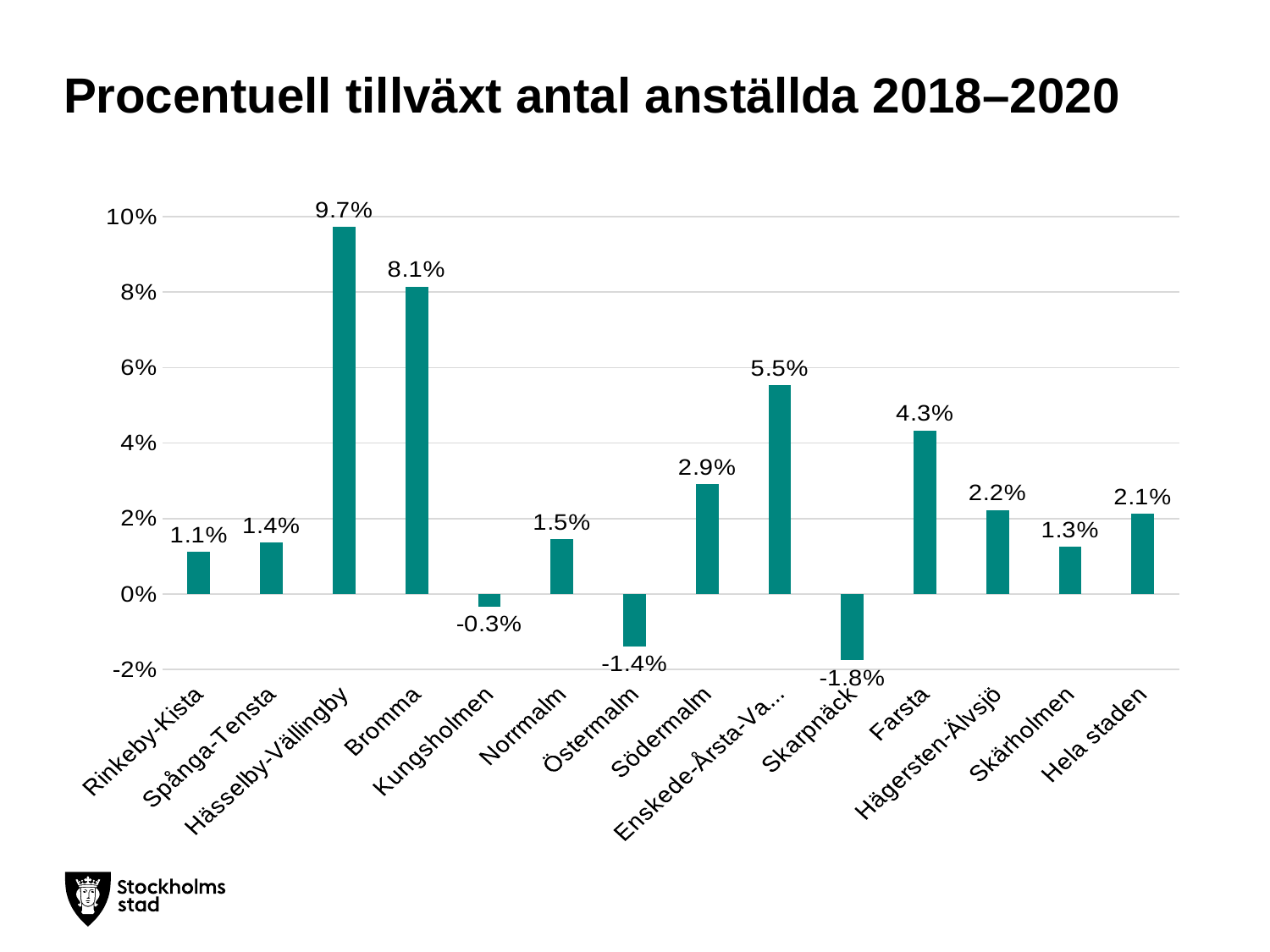
Is the value for Bromma greater or less than 6%? greater Which category has the highest value? Hässelby-Vällingby What is the value for Hela staden? 2.1% What is the difference between the values for Hässelby-Vällingby and Bromma? 1.6% Which category has the lowest value? Skarpnäck Which is larger, the value for Farsta or the value for Södermalm? Farsta What is the title of the chart? Procentuell tillväxt antal anställda 2018–2020 What is the value for Skarpnäck? -1.8% What kind of chart is shown on the slide? Bar chart What is the value for Hässelby-Vällingby? 9.7% How many categories are shown on the x axis? 14 What is the value for Kungsholmen? -0.3%